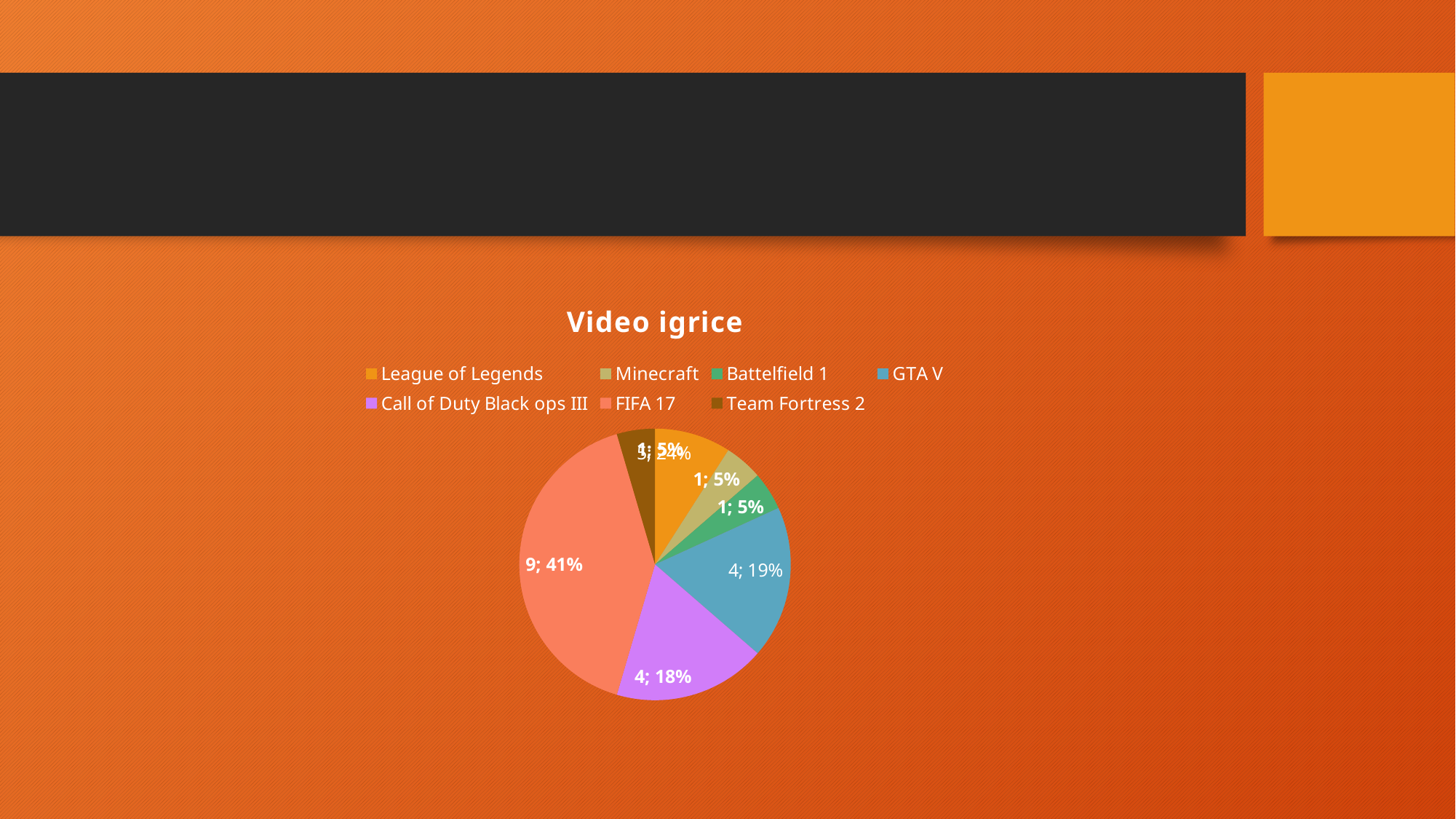
Which is larger, the slice for FIFA 17 or the slice for Call of Duty Black ops III? FIFA 17 What is the value for GTA V? 4 Which game has the largest slice of the pie? FIFA 17 What kind of chart is shown on the slide? pie chart What share of the pie does Call of Duty Black ops III have? 18% Which is larger, the slice for GTA V or the slice for Minecraft? GTA V What share of the pie does Battelfield 1 have? 5% What is the value for Minecraft? 1 How many categories does the pie chart have? 7 What is the title of the chart? Video igrice What is the difference between the value for FIFA 17 and the value for GTA V? 5 What share of the pie does FIFA 17 have? 41%